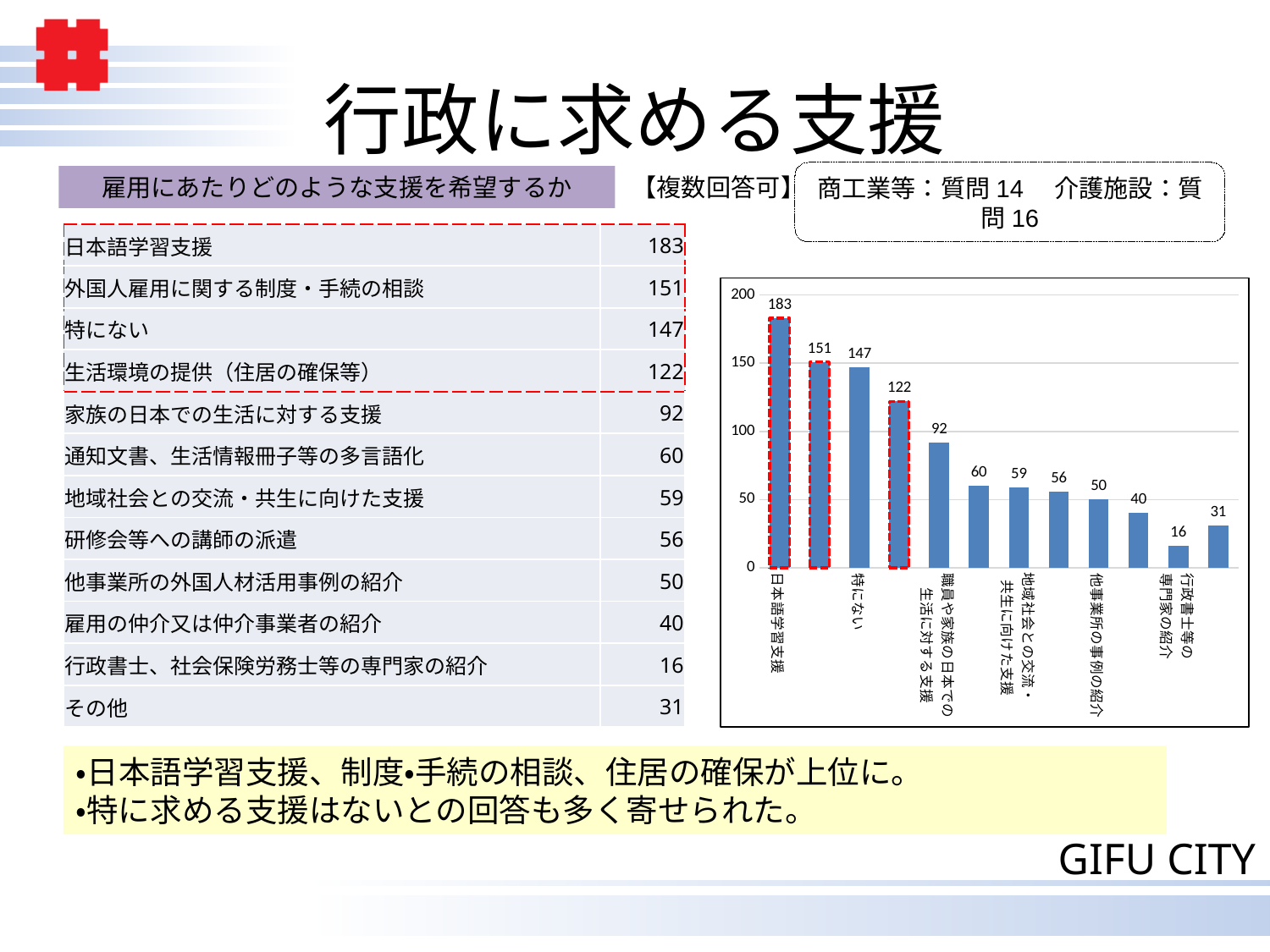
What is the value of the bar for 特にない? 147 What is the difference between the bar for 日本語学習支援 (183) and the bar for 特にない (147)? 36 Which category has the lowest bar in the chart? 行政書士等の専門家の紹介 What is the value of the bar for 地域社会との交流・共生に向けた支援? 59 Which category has the highest bar in the chart? 日本語学習支援 How many bars are plotted in the chart? 12 What type of chart is shown on the slide? bar chart Which is larger: the bar for 特にない or the bar for 地域社会との交流・共生に向けた支援? 特にない What is the highest tick value shown on the vertical axis of the chart? 200 What is the value of the bar for 日本語学習支援? 183 Is the value of the bar for 日本語学習支援 greater or less than 150? greater What is the value of the bar for 行政書士等の専門家の紹介? 16